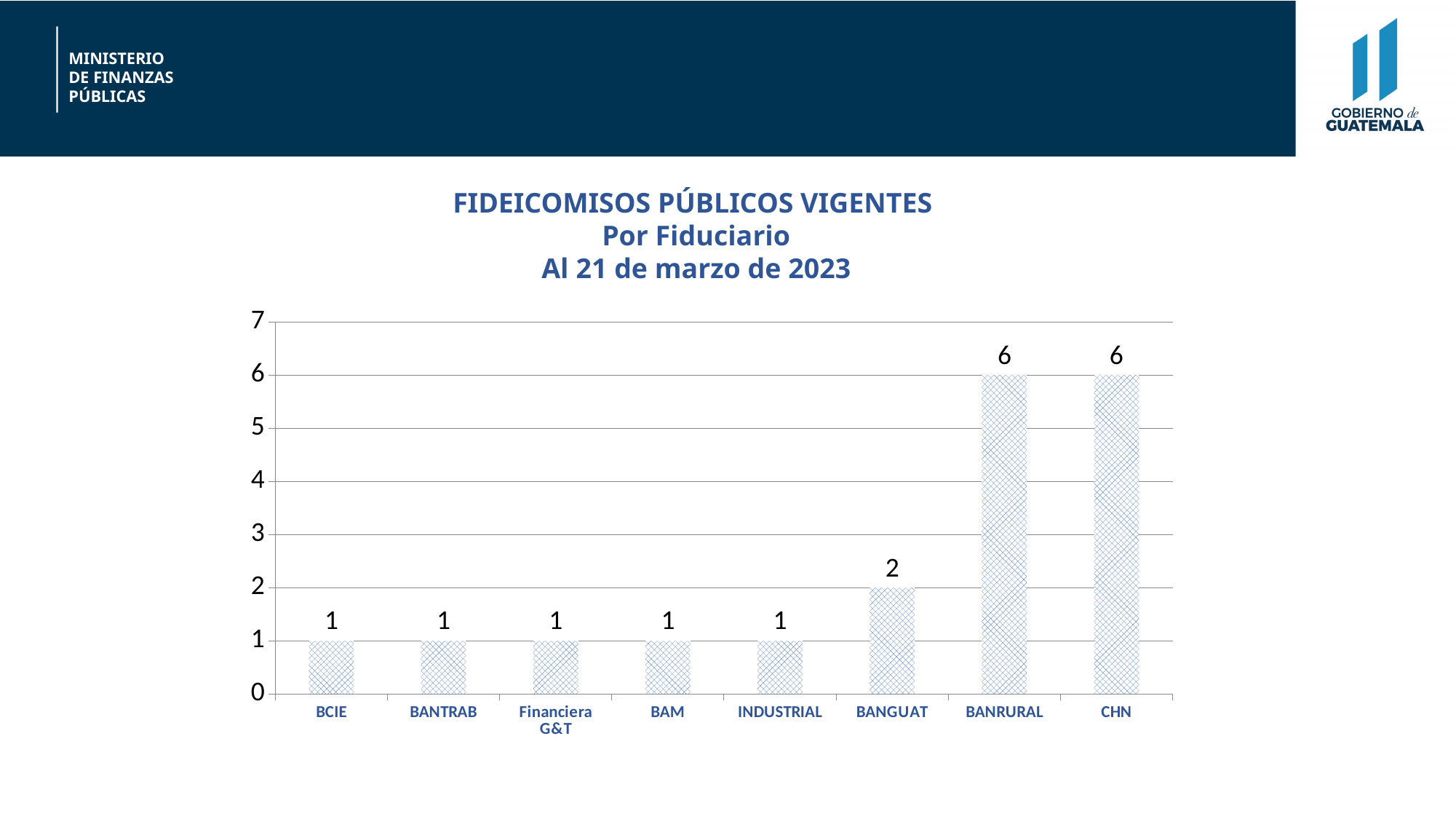
Which categories have the highest value? BANRURAL and CHN What is the difference between the values for CHN and BANGUAT? 4 What is the value for BANGUAT? 2 Is the value for BANRURAL greater or less than 4? greater What kind of chart is shown on the slide? bar chart What is the value for Financiera G&T? 1 How many categories are shown on the x axis? 8 What date is given in the chart title? 21 de marzo de 2023 What is the value for BANRURAL? 6 What is the total of the values for BANRURAL and CHN? 12 What is the value for INDUSTRIAL? 1 Which is larger, the value for BANGUAT or the value for BAM? BANGUAT